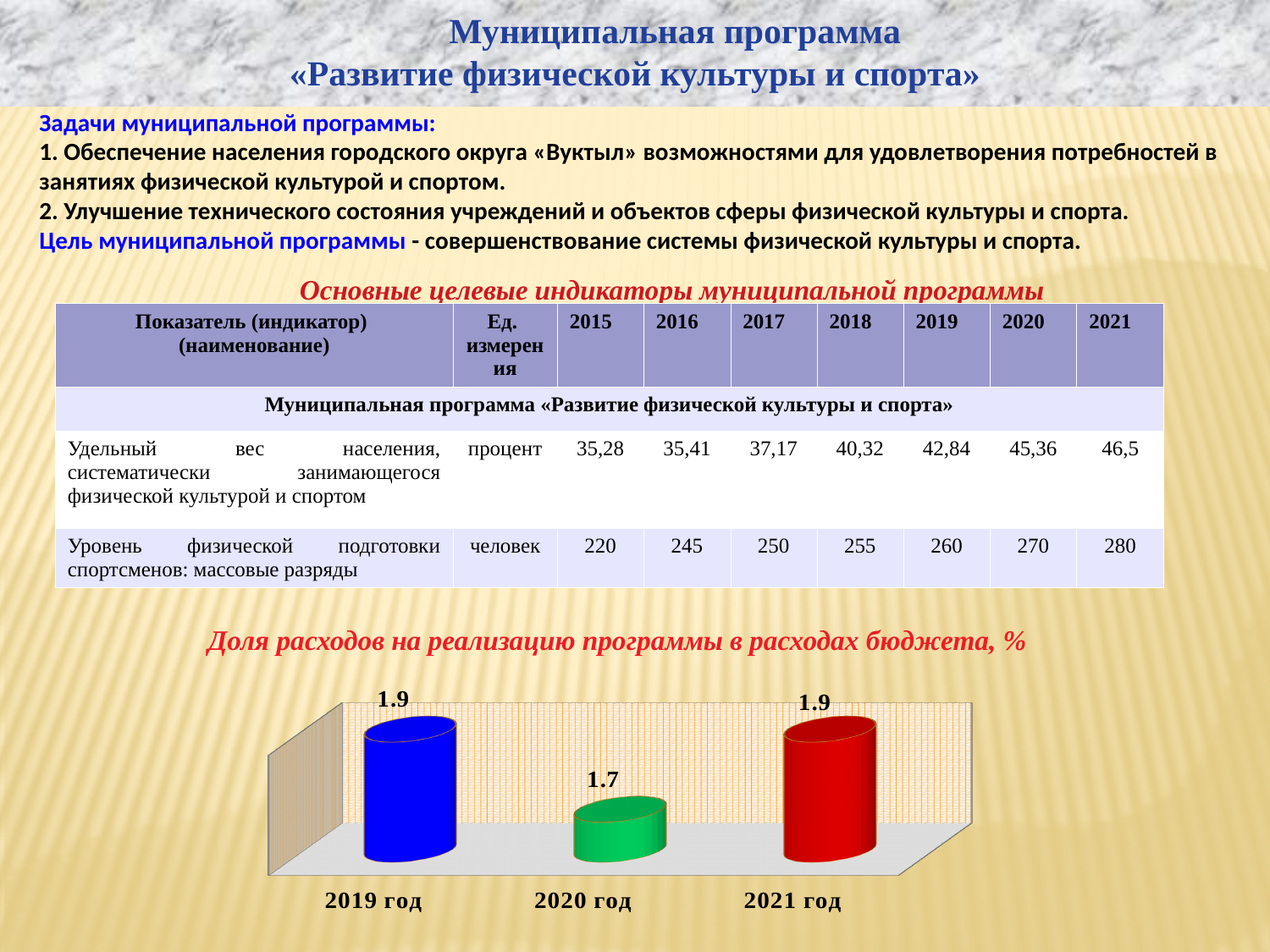
How many years are shown in the chart? 3 What is the value for 2021 год in the chart? 1.9 What colour is the bar for 2021 год? red Which is larger, the value for 2021 год or the value for 2020 год? 2021 год Does the value rise or fall from 2020 год to 2021 год? rise What is the value for 2020 год in the chart? 1.7 What is the value for 2019 год in the chart? 1.9 Does the value rise or fall from 2019 год to 2020 год? fall Which year has the lowest value in the chart? 2020 год What is the difference between the values for 2019 год and 2020 год? 0.2 What is the title of the chart? Доля расходов на реализацию программы в расходах бюджета, % What kind of chart is shown on the slide? bar chart